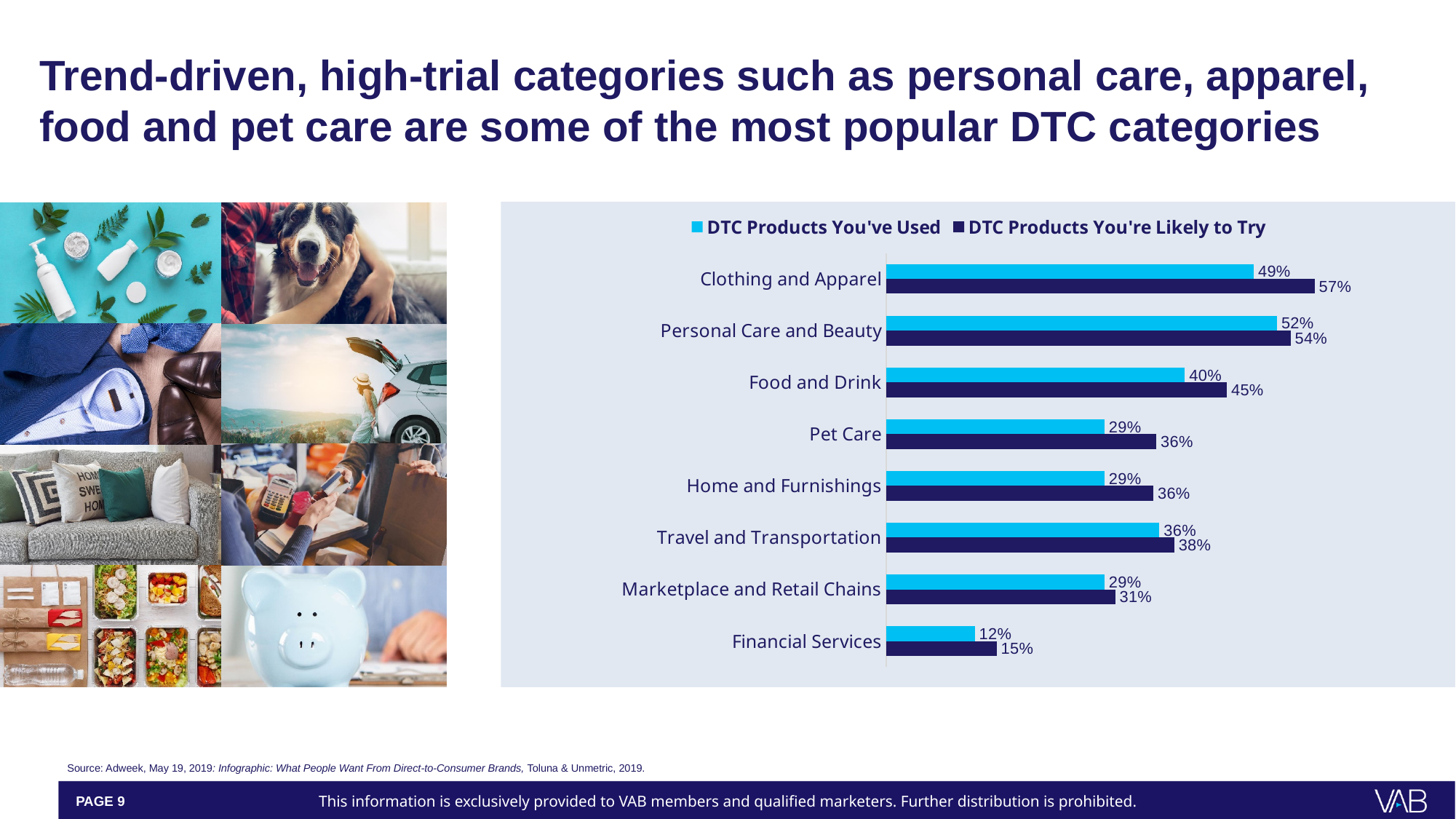
What is the 'DTC Products You've Used' value for Financial Services? 12% How many categories are shown in the chart? 8 Which category has the lowest value for 'DTC Products You've Used'? Financial Services Which is larger for Personal Care and Beauty: 'DTC Products You've Used' or 'DTC Products You're Likely to Try'? DTC Products You're Likely to Try What colour represents 'DTC Products You've Used' in the chart? Light blue What kind of chart is shown on the slide? Bar chart What is the difference between 'DTC Products You're Likely to Try' and 'DTC Products You've Used' for Clothing and Apparel? 8% Which category has the highest value for 'DTC Products You're Likely to Try'? Clothing and Apparel How many series does the legend list? 2 What percentage of respondents have used DTC products in the Clothing and Apparel category? 49% What is the value for 'DTC Products You're Likely to Try' in the Food and Drink category? 45% Which category has the highest value for 'DTC Products You've Used'? Personal Care and Beauty